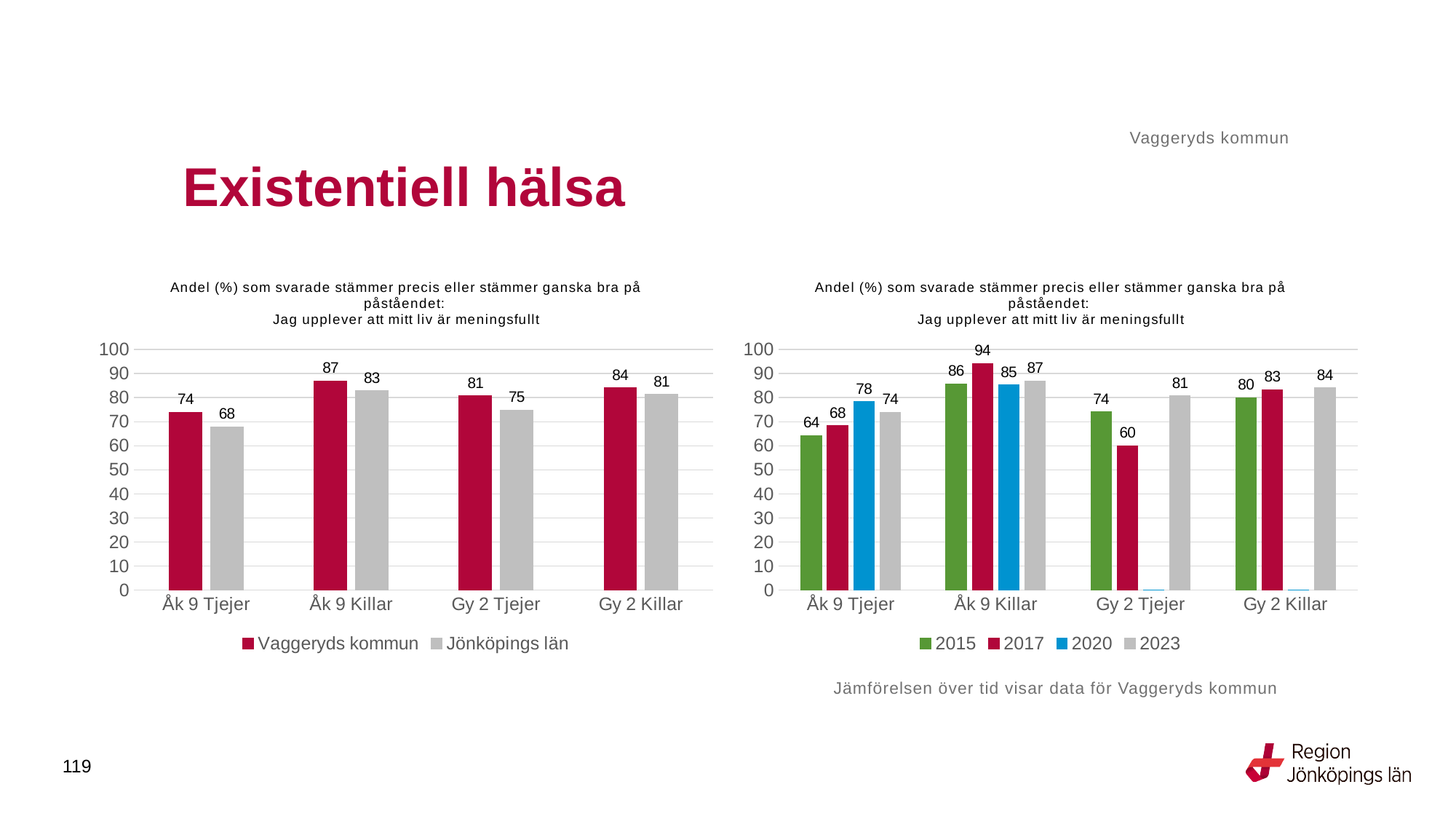
In the right chart, what is the difference between the 2023 and 2017 values for Gy 2 Tjejer? 21 In the right chart, how many series does the legend list? 4 In the left chart, what is the difference between Vaggeryds kommun and Jönköpings län for Åk 9 Tjejer? 6 In the left chart, which category has the lowest value for Jönköpings län? Åk 9 Tjejer In the right chart, which is larger for Gy 2 Killar: 2015 or 2023? 2023 In the right chart, which year has the lowest value for Gy 2 Tjejer? 2017 In the right chart, what is the value for 2020 for Åk 9 Tjejer? 78 In the left chart, what is the value for Jönköpings län for Gy 2 Tjejer? 75 In the right chart, what is the value for 2017 for Åk 9 Killar? 94 What type of chart is the left chart? Bar chart In the left chart, how many series does the legend list? 2 In the left chart, what is the value for Vaggeryds kommun for Åk 9 Killar? 87